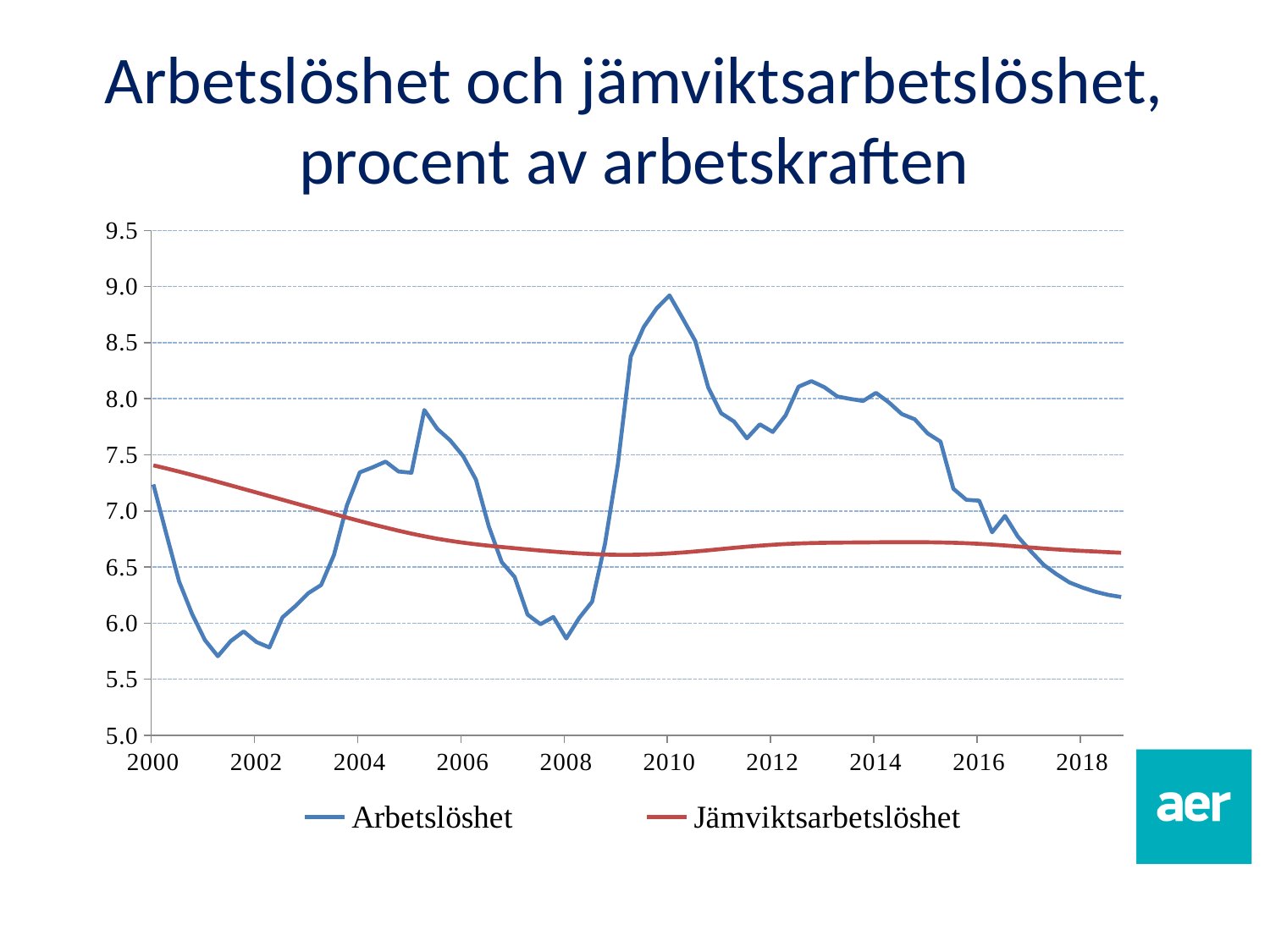
In 2010, which series has the higher value, Arbetslöshet or Jämviktsarbetslöshet? Arbetslöshet Does the Jämviktsarbetslöshet line rise or fall between 2000 and 2008? Fall Is the value for Arbetslöshet in 2008 greater or less than 6.5? less Is the value for Jämviktsarbetslöshet in 2000 greater or less than 7.0? greater Around which year does the Arbetslöshet line reach its highest point? 2010 In 2002, which series has the higher value, Arbetslöshet or Jämviktsarbetslöshet? Jämviktsarbetslöshet What are the two series named in the legend? Arbetslöshet and Jämviktsarbetslöshet How many series does the legend list? 2 Is the value for Arbetslöshet in 2010 greater or less than 8.5? greater What kind of chart is shown on the slide? Line chart Which colour is the Jämviktsarbetslöshet line? Red